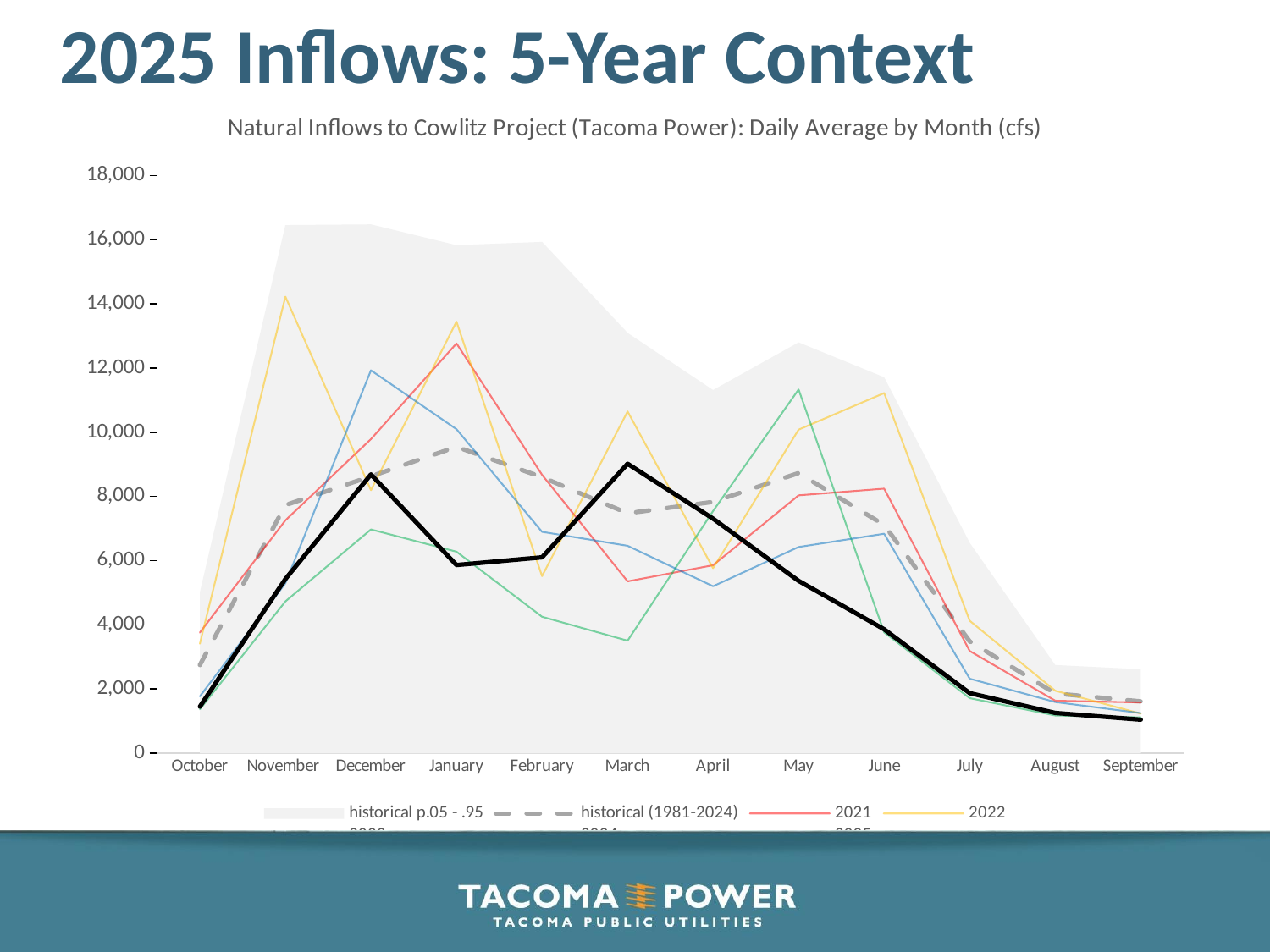
In November, which is larger: the 2021 value or the 2022 value? 2022 In which month does the 2022 line reach its highest value? November How many months are shown along the x axis? 12 Is the 2021 value for March greater or less than 6,000? less In which month does the 2021 line reach its highest value? January Is the 2021 value for January greater or less than 12,000? greater Does the 2021 line rise or fall from June to September? fall What kind of chart is shown on the slide? line chart What is the chart's title? Natural Inflows to Cowlitz Project (Tacoma Power): Daily Average by Month (cfs) Is the value of the thick black line for March greater or less than 8,000? greater Which month is the first category on the x axis? October